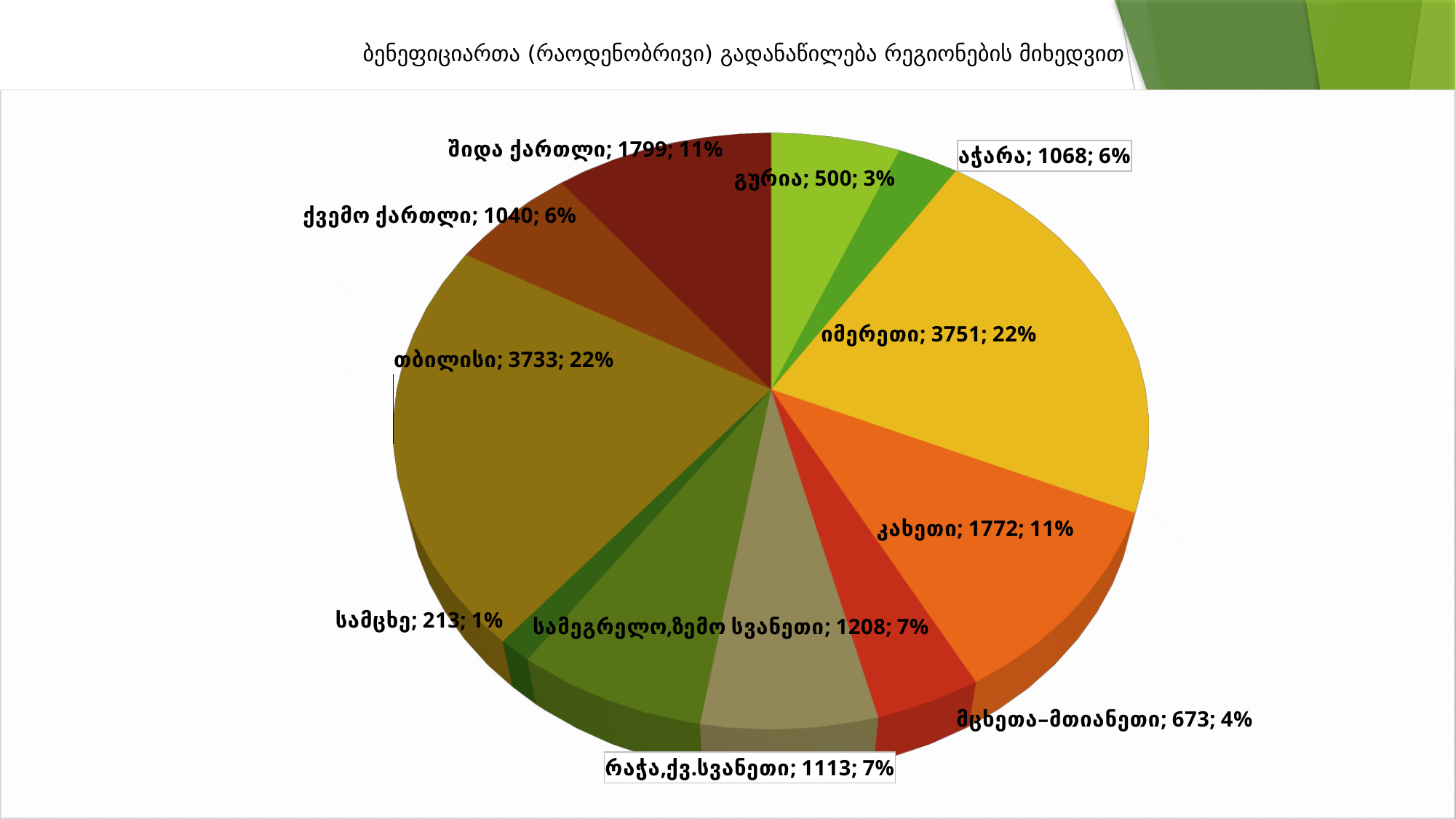
What is the value for იმერეთი? 3751 What is the value for მცხეთა-მთიანეთი? 673 What is the value for შიდა ქართლი? 1799 What is the title of the chart? ბენეფიციართა (რაოდენობრივი) გადანაწილება რეგიონების მიხედვით What percentage share does სამცხე have? 1% What type of chart is shown on the slide? pie chart What is the difference between the values for კახეთი and აჭარა? 704 Which region has the lowest value? სამცხე Which is larger, the value for სამეგრელო,ზემო სვანეთი or the value for რაჭა,ქვ.სვანეთი? სამეგრელო,ზემო სვანეთი What percentage share does თბილისი have? 22% How many regions (slices) does the pie chart show? 11 Which region has the highest value? იმერეთი